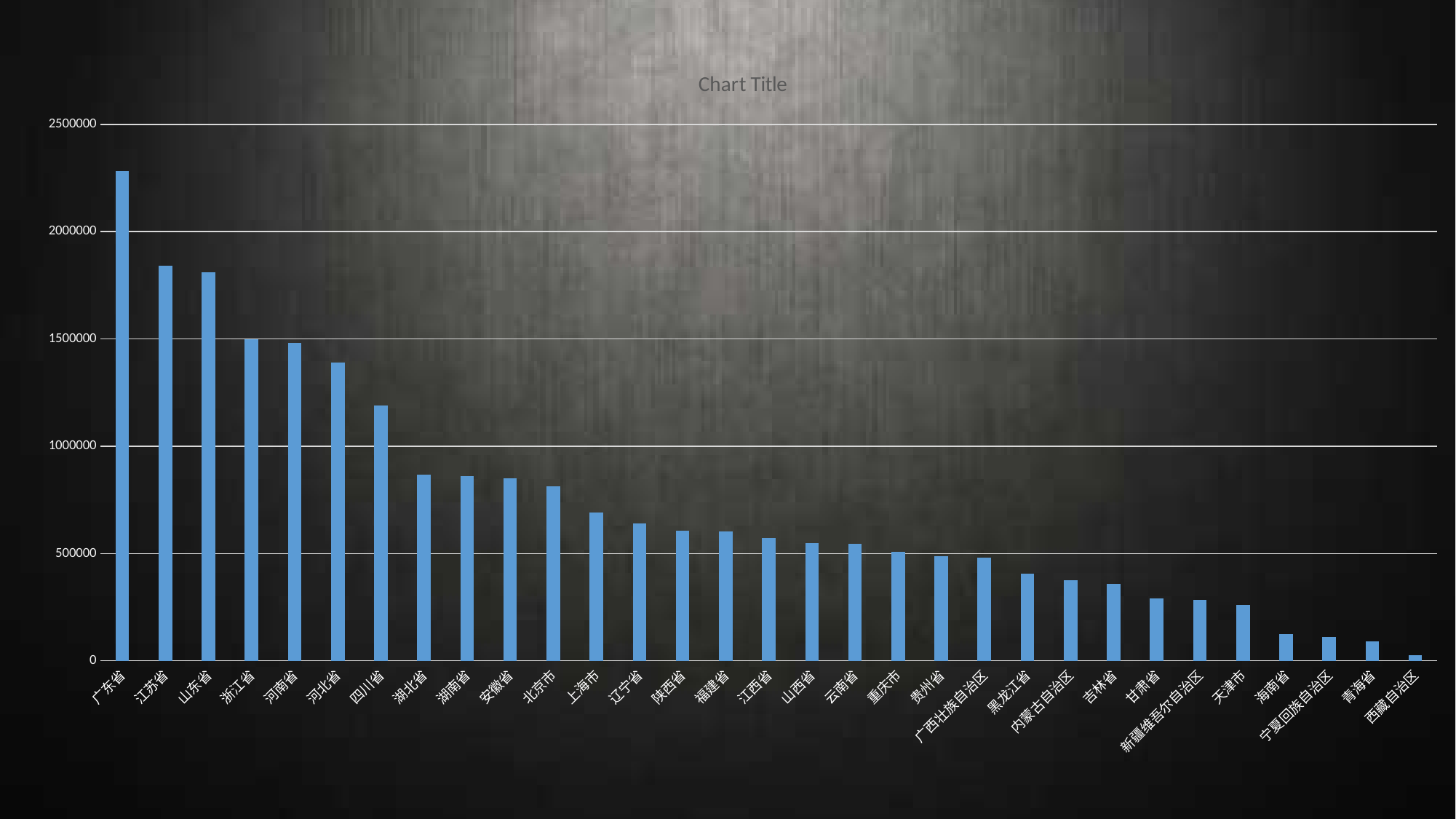
Is the value for 湖北省 greater or less than 1000000? less How many categories are plotted on the x axis? 31 Which category has the lowest value? 西藏自治区 What kind of chart is shown on the slide? bar chart Do the values rise or fall moving from left to right along the x axis? fall Is the value for 广东省 greater or less than 2000000? greater Is the value for 黑龙江省 greater or less than 500000? less Which is larger, the value for 山东省 or the value for 浙江省? 山东省 Which category has the highest value? 广东省